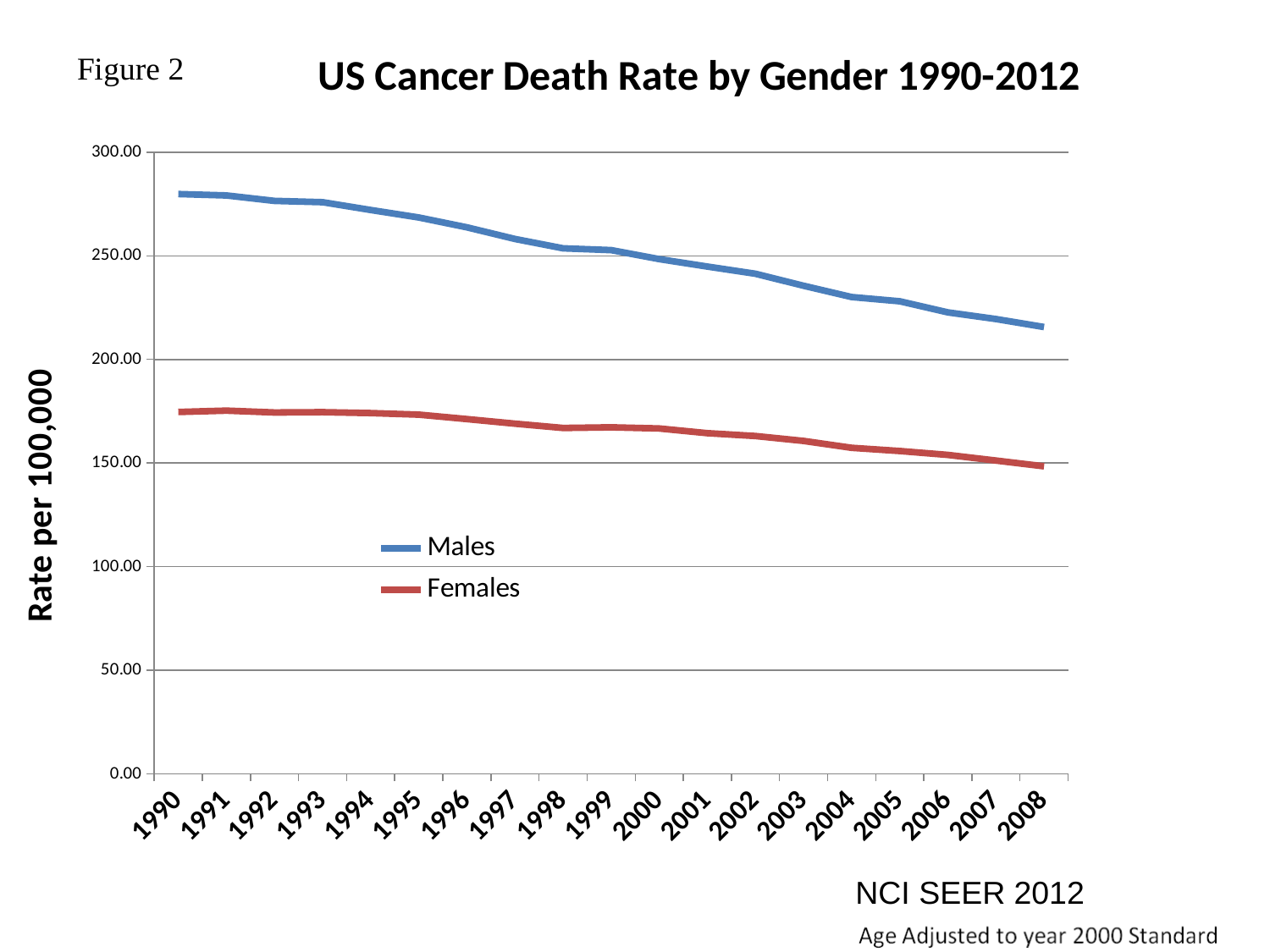
Is the value for Males in 1990 greater or less than 250? greater What is the title of the chart? US Cancer Death Rate by Gender 1990-2012 In which year is the Males series at its highest? 1990 How many series does the legend list? 2 Do the values for Males rise or fall from 1990 to 2008? Fall In which year is the Males series at its lowest? 2008 In 2000, which series has the larger value, Males or Females? Males What is the label on the vertical axis? Rate per 100,000 Is the value for Males in 2008 greater or less than 250? less What kind of chart is shown on the slide? Line chart How many years are plotted along the x axis? 19 Do the values for Females rise or fall from 1990 to 2008? Fall